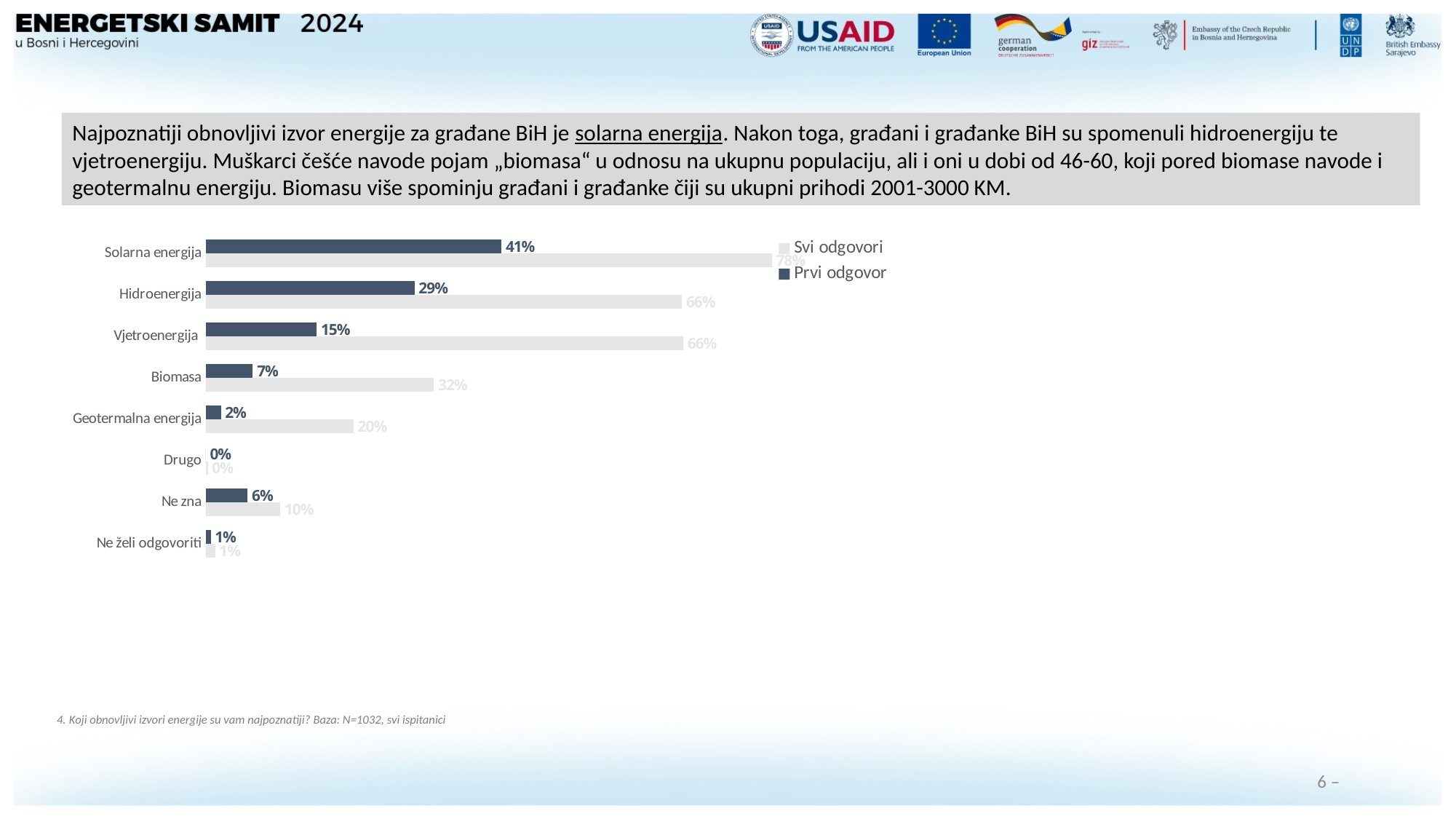
Which is larger: the 'Prvi odgovor' value for Biomasa or for Ne zna? Biomasa What is the 'Prvi odgovor' value for Solarna energija? 41% What is the difference between the 'Svi odgovori' and 'Prvi odgovor' values for Vjetroenergija? 51 percentage points What is the 'Prvi odgovor' value for Geotermalna energija? 2% Which category has the lowest 'Svi odgovori' value? Drugo How many categories are shown on the chart? 8 What kind of chart is shown on the slide? Bar chart What is the 'Svi odgovori' value for Hidroenergija? 66% What is the 'Svi odgovori' value for Biomasa? 32% Which series is shown in the dark colour according to the legend? Prvi odgovor How many series does the legend list? 2 Which category has the highest 'Prvi odgovor' value? Solarna energija